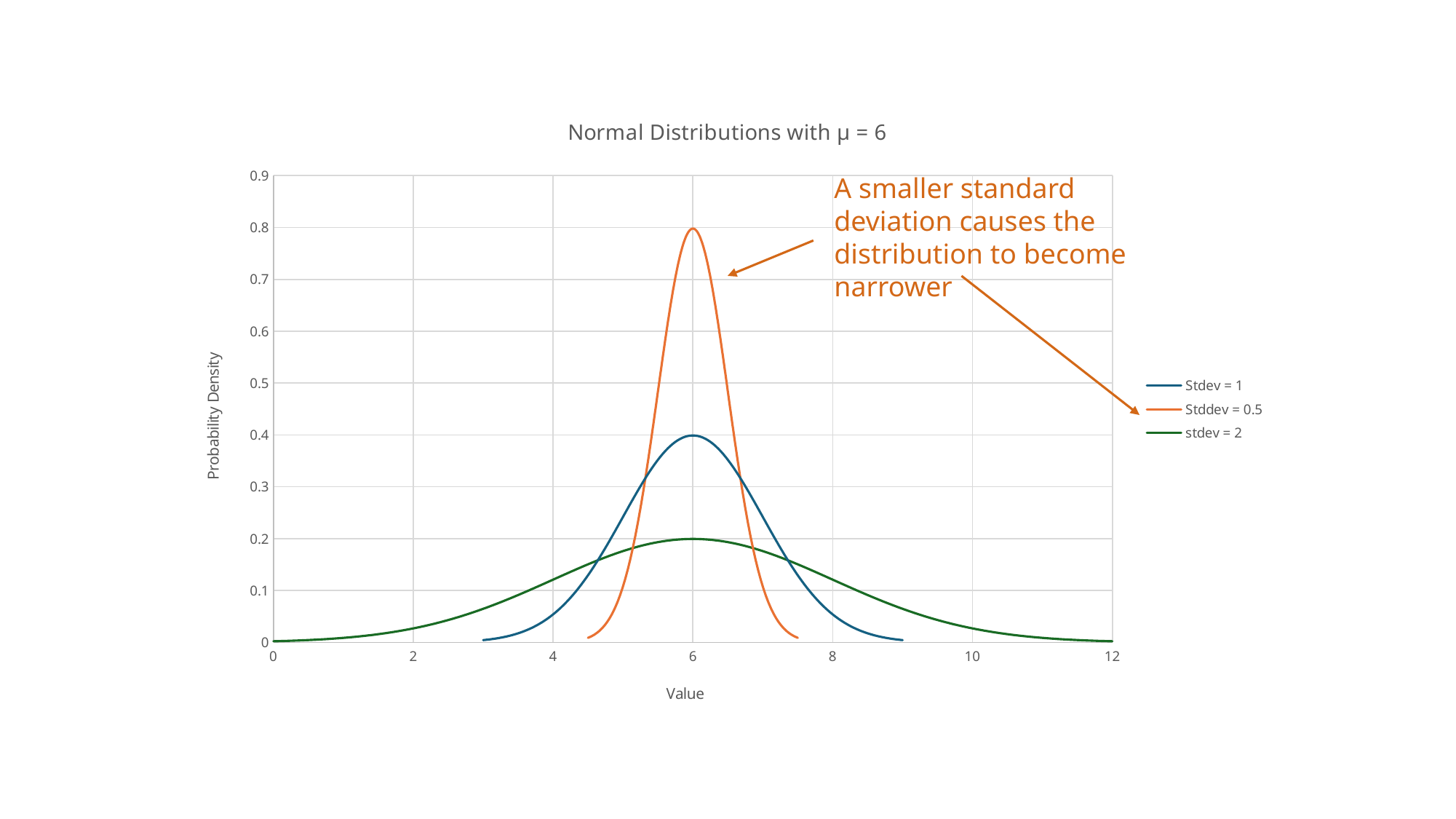
What kind of chart is shown on the slide? line chart What is the peak probability density of the Stdev = 1 series at Value 6? 0.4 How many series does the legend list? 3 What is the peak probability density of the Stddev = 0.5 series at Value 6? 0.8 What is the peak probability density of the stdev = 2 series at Value 6? 0.2 What is the difference between the peak of the Stddev = 0.5 series and the peak of the Stdev = 1 series? 0.4 What is the title of the chart? Normal Distributions with μ = 6 Does the Stddev = 0.5 series rise or fall as Value goes from 6 to 8? fall Which series reaches the highest probability density? Stddev = 0.5 Which series has the lowest peak probability density? stdev = 2 Is the probability density of the stdev = 2 series at Value 4 greater or less than 0.2? less At Value 6, which series has the larger probability density, Stdev = 1 or stdev = 2? Stdev = 1